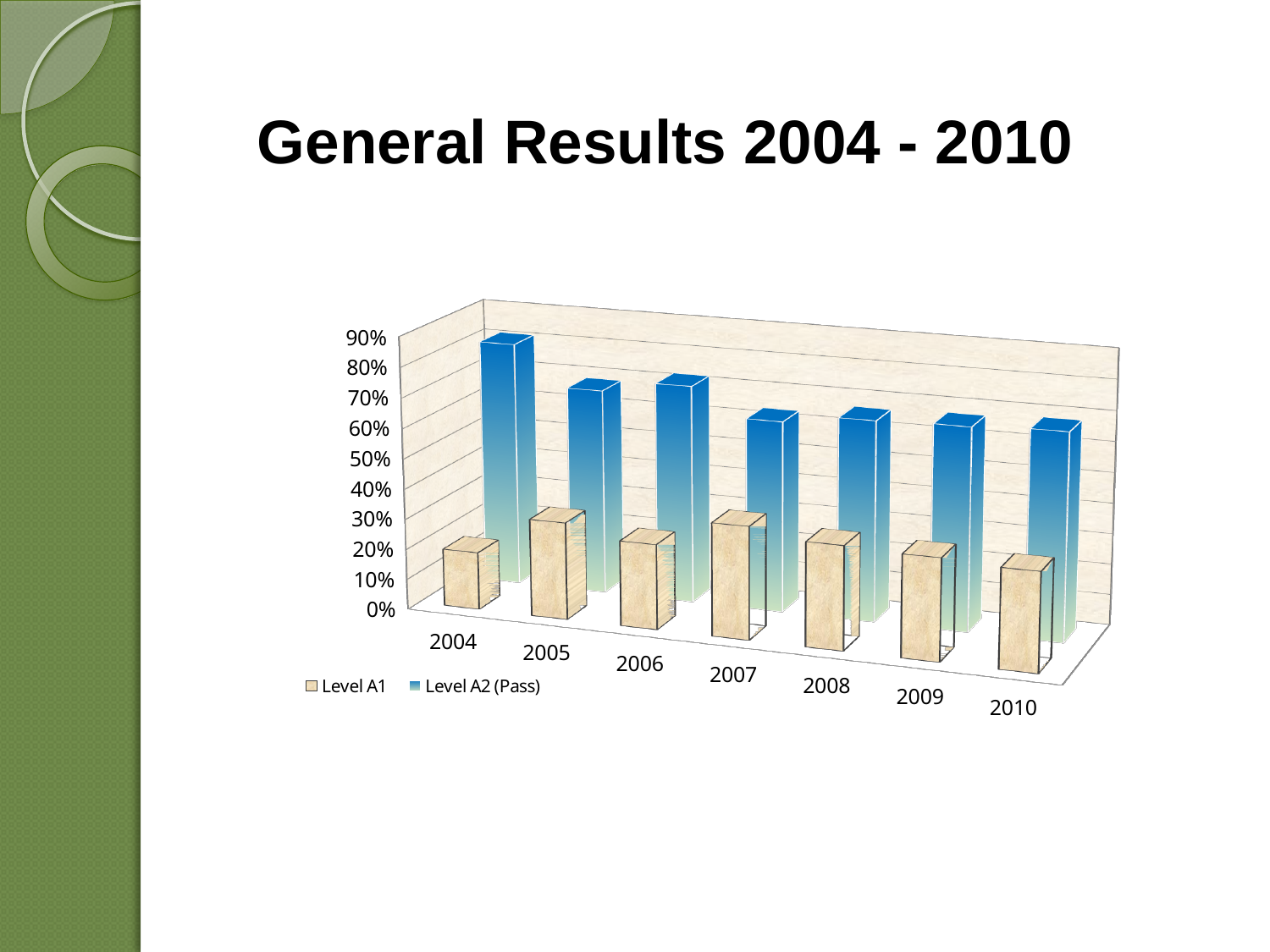
Do the Level A2 (Pass) values generally rise or fall from 2004 to 2010? fall How many series does the legend list? 2 What kind of chart is shown on the slide? bar chart How many years are shown on the x axis of the chart? 7 What is the title of the slide containing the chart? General Results 2004 - 2010 Is the value for Level A1 in 2004 greater or less than 50%? less Which is larger for Level A2 (Pass), the value in 2004 or the value in 2010? 2004 Which is larger in 2004, Level A1 or Level A2 (Pass)? Level A2 (Pass) Is the value for Level A2 (Pass) in 2004 greater or less than 80%? greater Which year has the highest value for Level A2 (Pass)? 2004 Is the value for Level A2 (Pass) in 2010 greater or less than 80%? less What are the two series named in the chart legend? Level A1 and Level A2 (Pass)